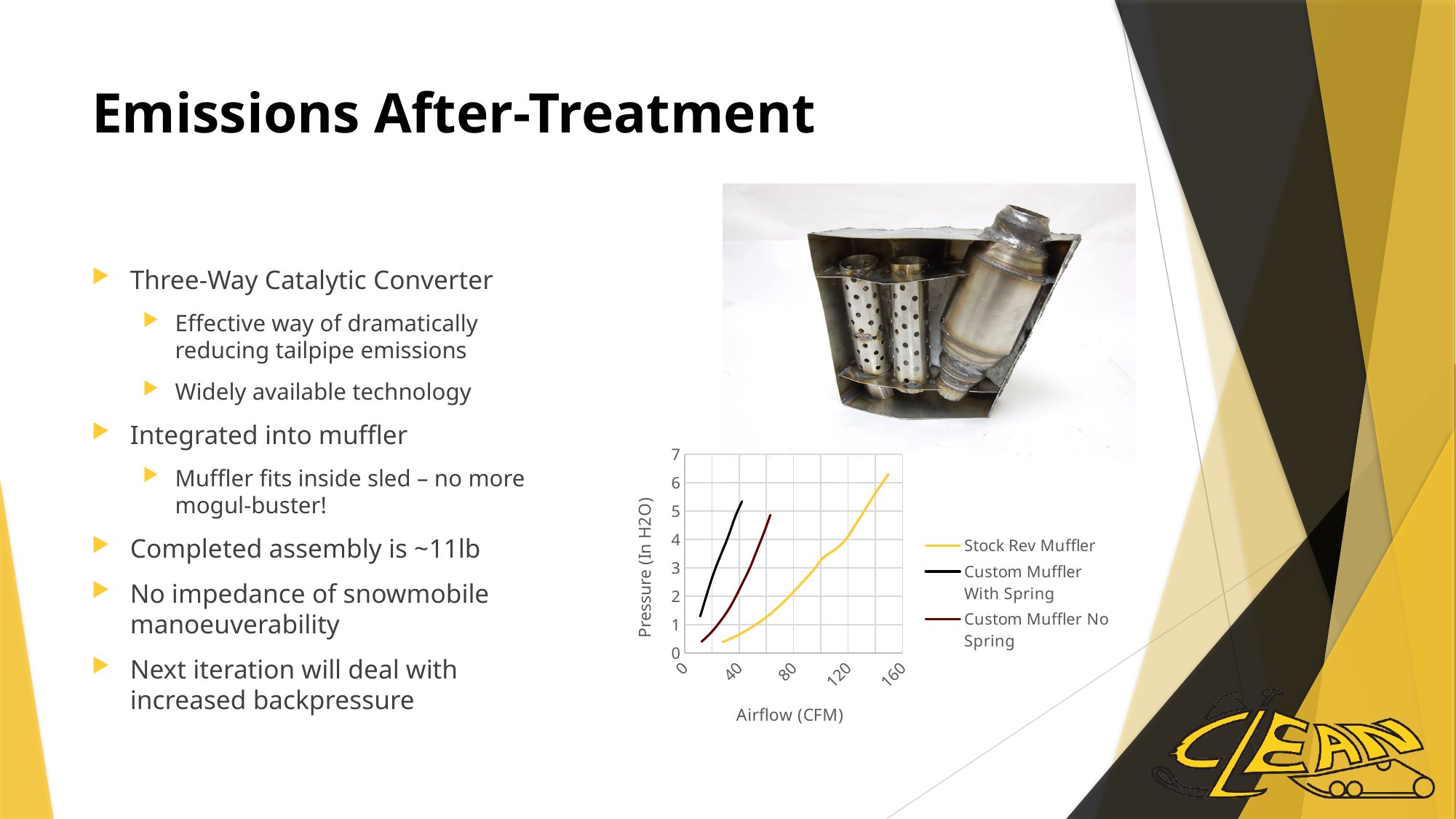
What kind of chart is shown on the slide? line chart Does the pressure for the Stock Rev Muffler rise or fall as airflow increases? rise How many series does the chart legend list? 3 Is the highest pressure reached by the Custom Muffler With Spring greater or less than 6? less What is the label of the y axis of the chart? Pressure (In H2O) At 40 CFM, which has the higher pressure: the Custom Muffler With Spring or the Stock Rev Muffler? Custom Muffler With Spring Which series extends to the highest airflow on the chart? Stock Rev Muffler Is the pressure for the Stock Rev Muffler at 80 CFM greater or less than 3? less Which series reaches the highest pressure on the chart? Stock Rev Muffler What is the label of the x axis of the chart? Airflow (CFM) Is the highest pressure reached by the Custom Muffler No Spring greater or less than 4? greater